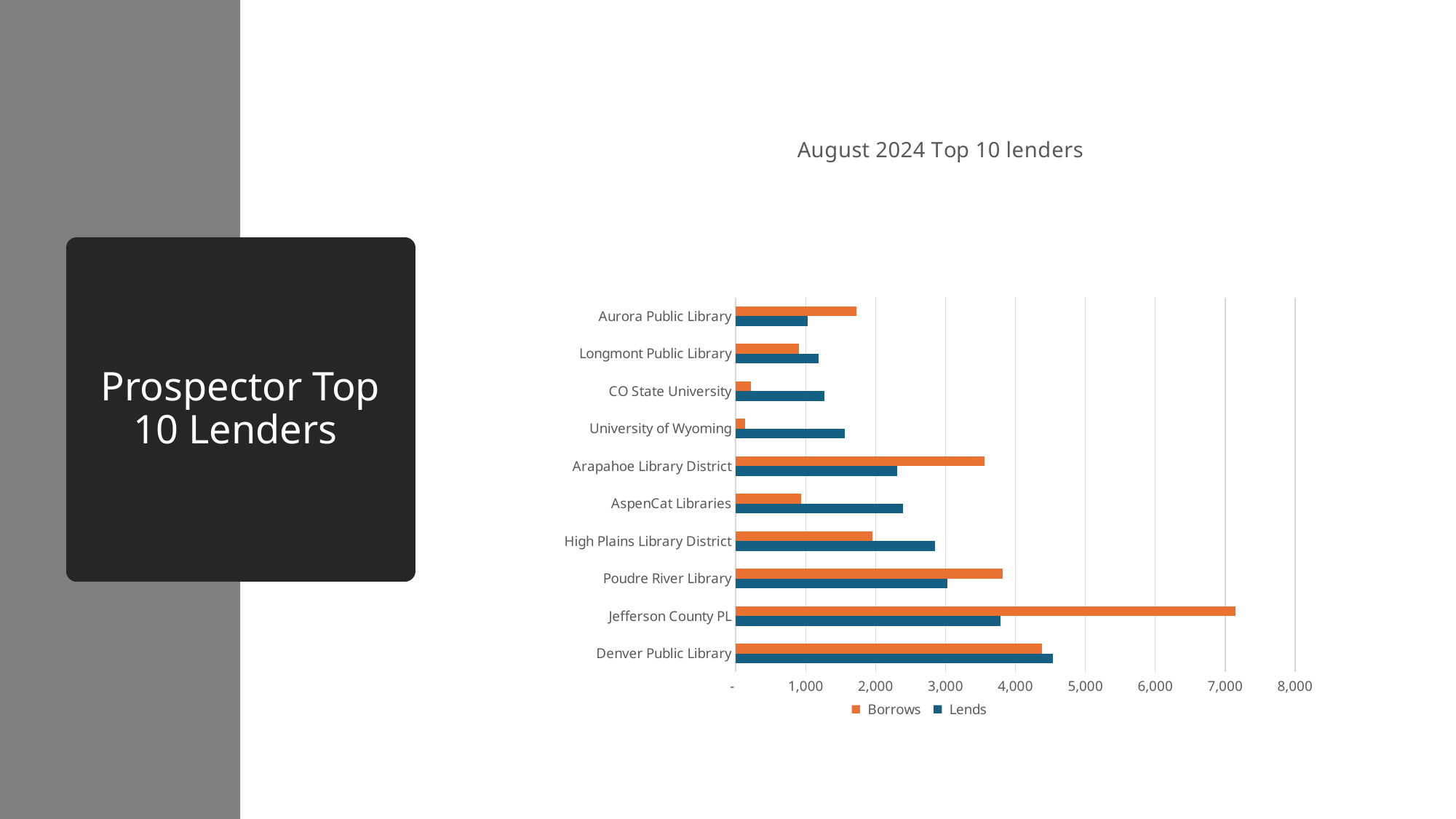
How many series does the legend list? 2 What is the title of the chart? August 2024 Top 10 lenders Which library has the lowest Borrows value? University of Wyoming What kind of chart is shown on the slide? Bar chart Which library has the highest Borrows value? Jefferson County PL How many libraries are shown on the chart? 10 Is the Borrows value for CO State University greater or less than 1,000? less Which library has the highest Lends value? Denver Public Library For Poudre River Library, which is larger, Borrows or Lends? Borrows For AspenCat Libraries, which is larger, Borrows or Lends? Lends Is the Lends value for Denver Public Library greater or less than 4,000? greater Is the Borrows value for Jefferson County PL greater or less than 7,000? greater